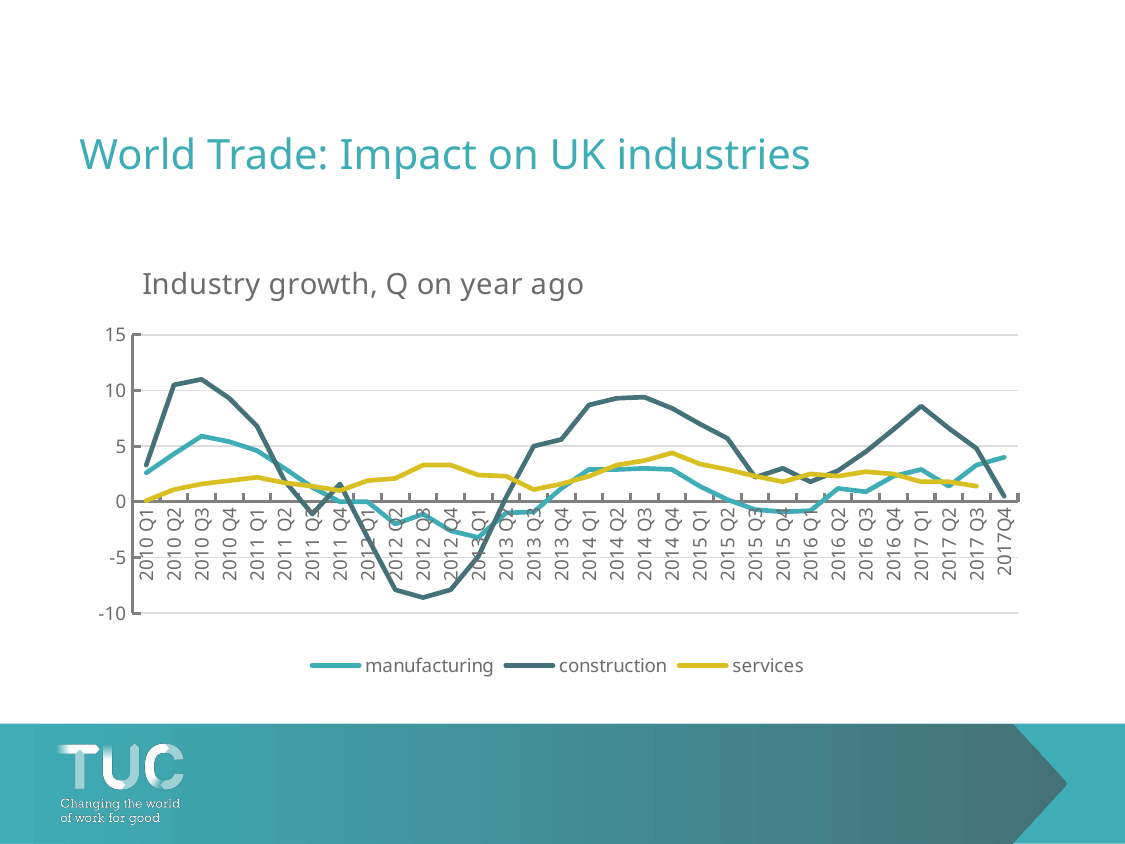
Which series reaches the lowest value anywhere on the chart? construction Which series reaches the highest value anywhere on the chart? construction What kind of chart is shown on the slide? line chart Is the value for construction in 2012 Q3 greater or less than -5? less What are the three series named in the legend? manufacturing, construction, services What is the title of the chart? Industry growth, Q on year ago In 2012 Q3, which is higher: services or construction? services How many quarters are labelled along the x axis? 32 Is the value for construction in 2014 Q3 greater or less than 5? greater Is the value for manufacturing in 2012 Q3 greater or less than 0? less How many series does the legend list? 3